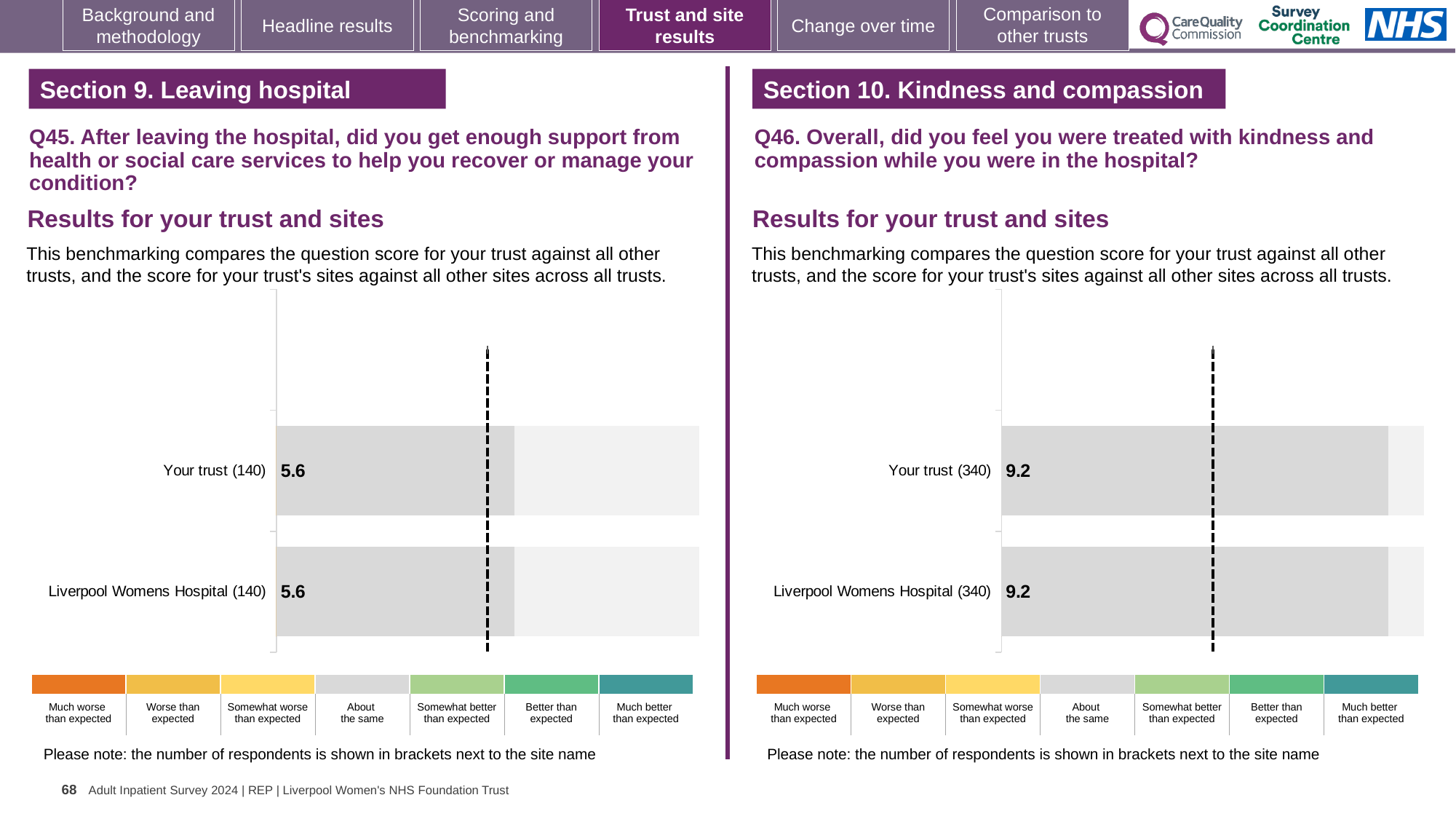
What kind of chart is used for the Q46 results on the right? Bar chart In the Q45 chart on the left, what is the score for Liverpool Womens Hospital? 5.6 How many bars are plotted in the Q45 chart on the left? 2 In the Q46 chart on the right, what is the score for Your trust? 9.2 In the Q46 chart on the right, how many respondents are shown in brackets for Liverpool Womens Hospital? 340 In the Q46 chart on the right, what is the score for Liverpool Womens Hospital? 9.2 How many bars are plotted in the Q46 chart on the right? 2 In the Q45 chart on the left, how many respondents are shown in brackets for Your trust? 140 In the Q45 chart on the left, what is the score for Your trust? 5.6 In the colour key below the Q46 chart on the right, which category is shown in orange? Much worse than expected What is the difference between the Your trust score in the Q46 chart on the right and the Your trust score in the Q45 chart on the left? 3.6 How many rating categories are shown in the colour key below the Q45 chart on the left? 7